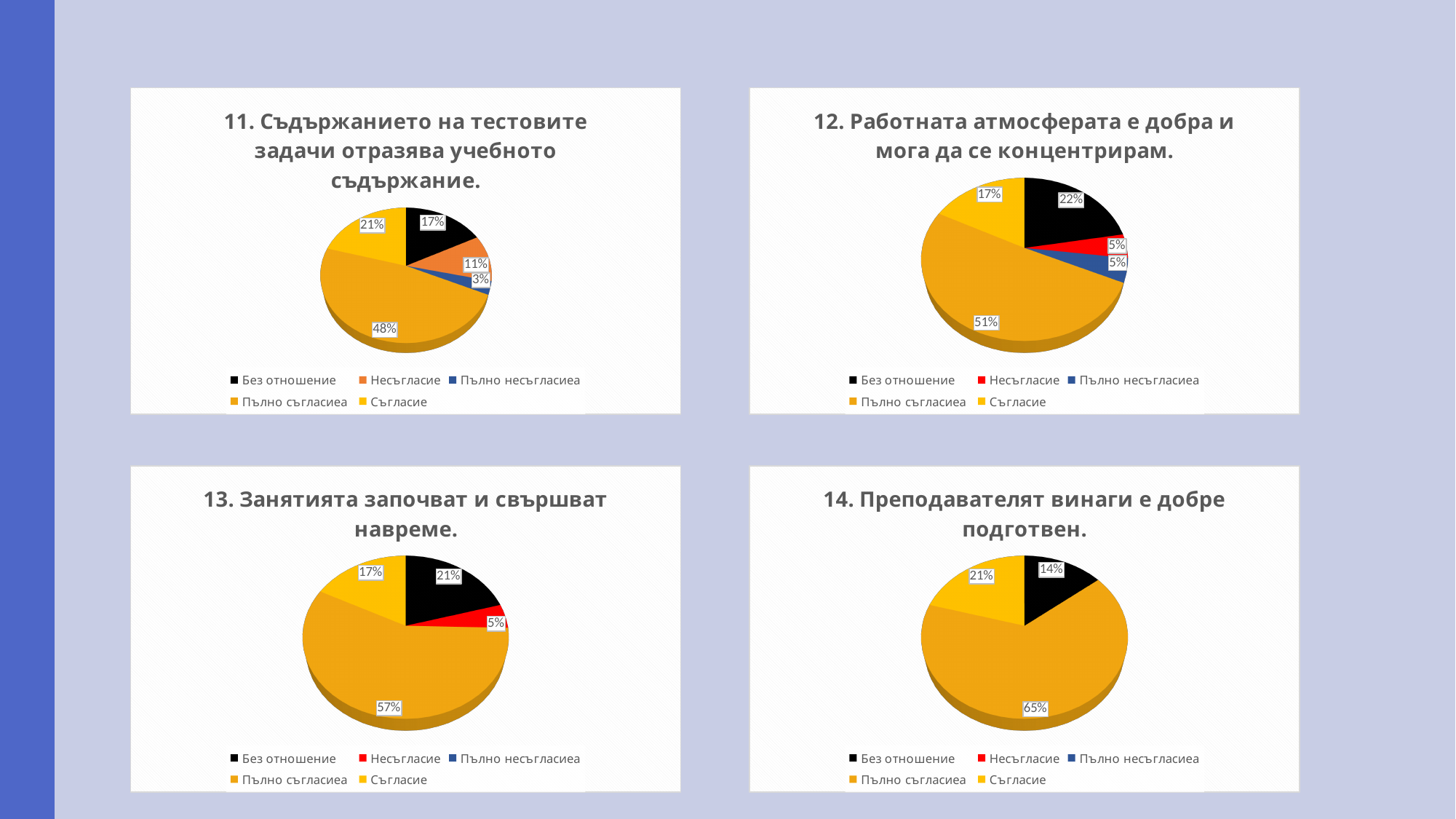
In chart 13 (Занятията започват и свършват навреме), what is the difference between the Без отношение slice and the Несъгласие slice? 16% In chart 14 (Преподавателят винаги е добре подготвен), what share is labelled for Съгласие? 21% In chart 11 (Съдържанието на тестовите задачи отразява учебното съдържание), what share is labelled for Пълно съгласие? 48% In chart 13 (Занятията започват и свършват навреме), what share is labelled for Пълно съгласие? 57% How many entries does the legend of chart 13 (Занятията започват и свършват навреме) list? 5 In chart 12 (Работната атмосферата е добра и мога да се концентрирам), which category has the largest slice? Пълно съгласие In chart 14 (Преподавателят винаги е добре подготвен), which category has the smallest labelled slice? Без отношение What kind of chart is chart 12 (Работната атмосферата е добра и мога да се концентрирам)? Pie chart In chart 11 (Съдържанието на тестовите задачи отразява учебното съдържание), what share is labelled for Пълно несъгласие? 3% In chart 14 (Преподавателят винаги е добре подготвен), what is the combined share of Пълно съгласие and Съгласие? 86% In chart 12 (Работната атмосферата е добра и мога да се концентрирам), what share is labelled for Без отношение? 22% In chart 11 (Съдържанието на тестовите задачи отразява учебното съдържание), which is larger: the Съгласие slice or the Без отношение slice? Съгласие